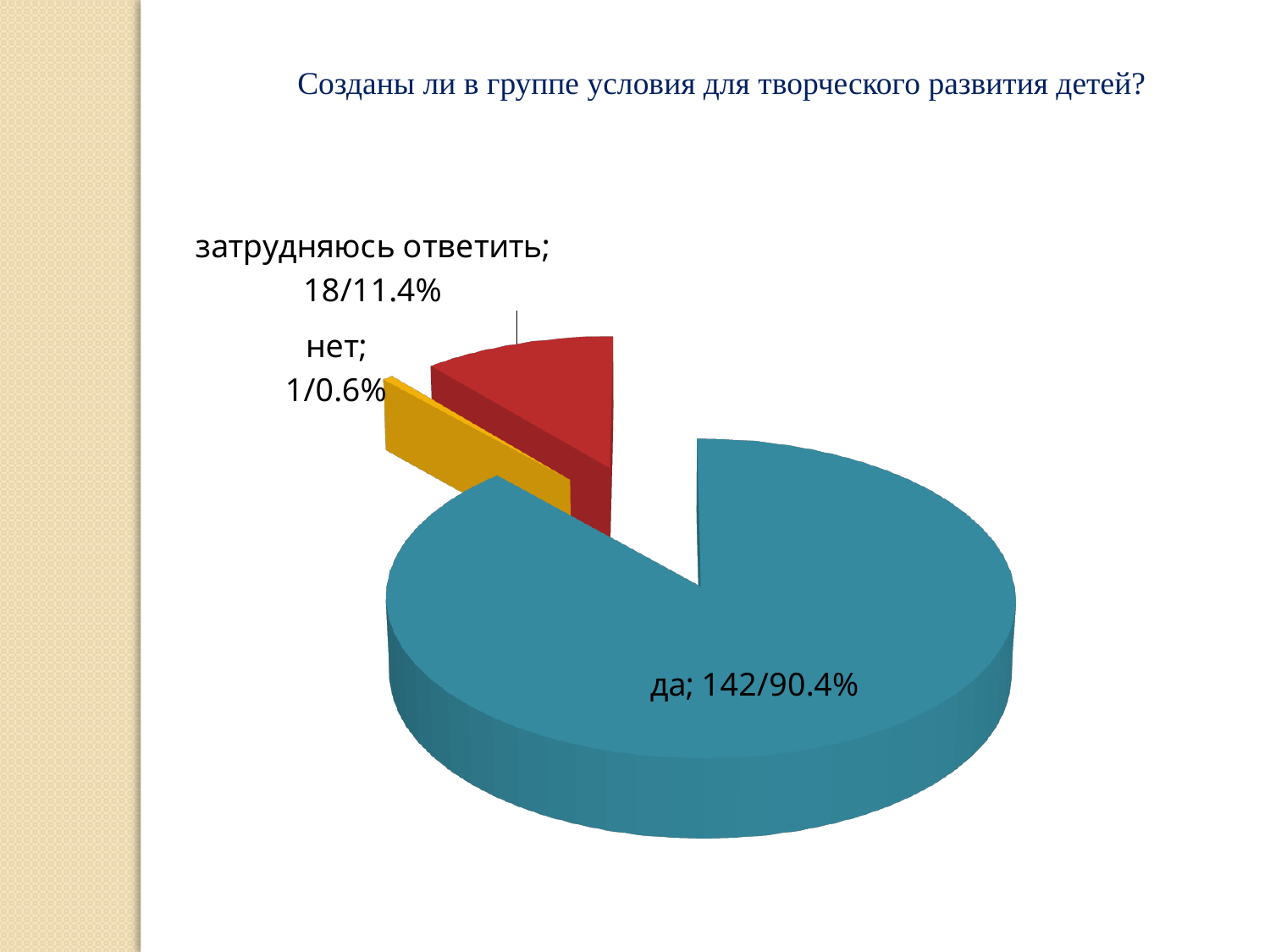
What is the data label for the "да" slice? 142/90.4% Which category has the largest slice of the pie? да Which category has the smallest slice of the pie? нет What kind of chart is shown on the slide? pie chart What is the data label for the "нет" slice? 1/0.6% How many more respondents answered "да" than "затрудняюсь ответить"? 124 What share of the pie does the "да" slice represent? 90.4% Which is larger, the "нет" slice or the "затрудняюсь ответить" slice? затрудняюсь ответить What is the data label for the "затрудняюсь ответить" slice? 18/11.4% What share of the pie does the "затрудняюсь ответить" slice represent? 11.4% How many slices does the pie chart have? 3 What is the title of the chart? Созданы ли в группе условия для творческого развития детей?